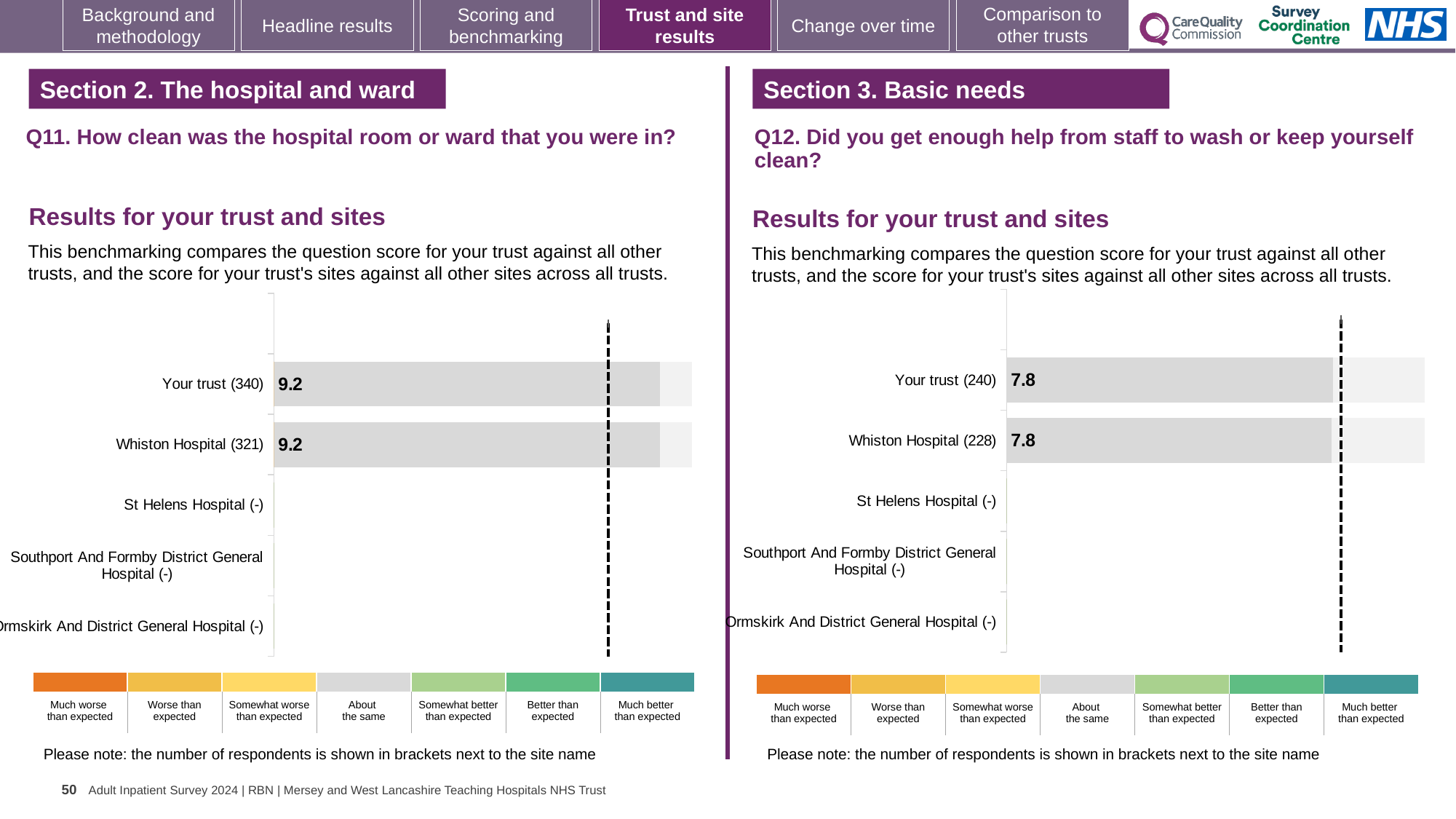
How many site or trust categories are listed on the y axis of the Q12 chart on the right? 5 In the Q12 chart on the right, how many respondents are shown in brackets for Your trust? 240 In the Q11 chart on the left, what is the difference between the scores for Your trust and Whiston Hospital? 0 In the Q11 chart on the left, what is the score for Your trust? 9.2 Is the score for Your trust in the Q11 chart on the left larger than the score for Your trust in the Q12 chart on the right? Yes How many site or trust categories are listed on the y axis of the Q11 chart on the left? 5 In the Q12 chart on the right, what is the score for Your trust? 7.8 In the Q12 chart on the right, what is the difference between the scores for Your trust and Whiston Hospital? 0 In the Q11 chart on the left, how many respondents are shown in brackets for Whiston Hospital? 321 In the Q11 chart on the left, what is the score for Whiston Hospital? 9.2 In the Q12 chart on the right, what is the score for Whiston Hospital? 7.8 What kind of chart is used for the Q11 results on the left? Bar chart